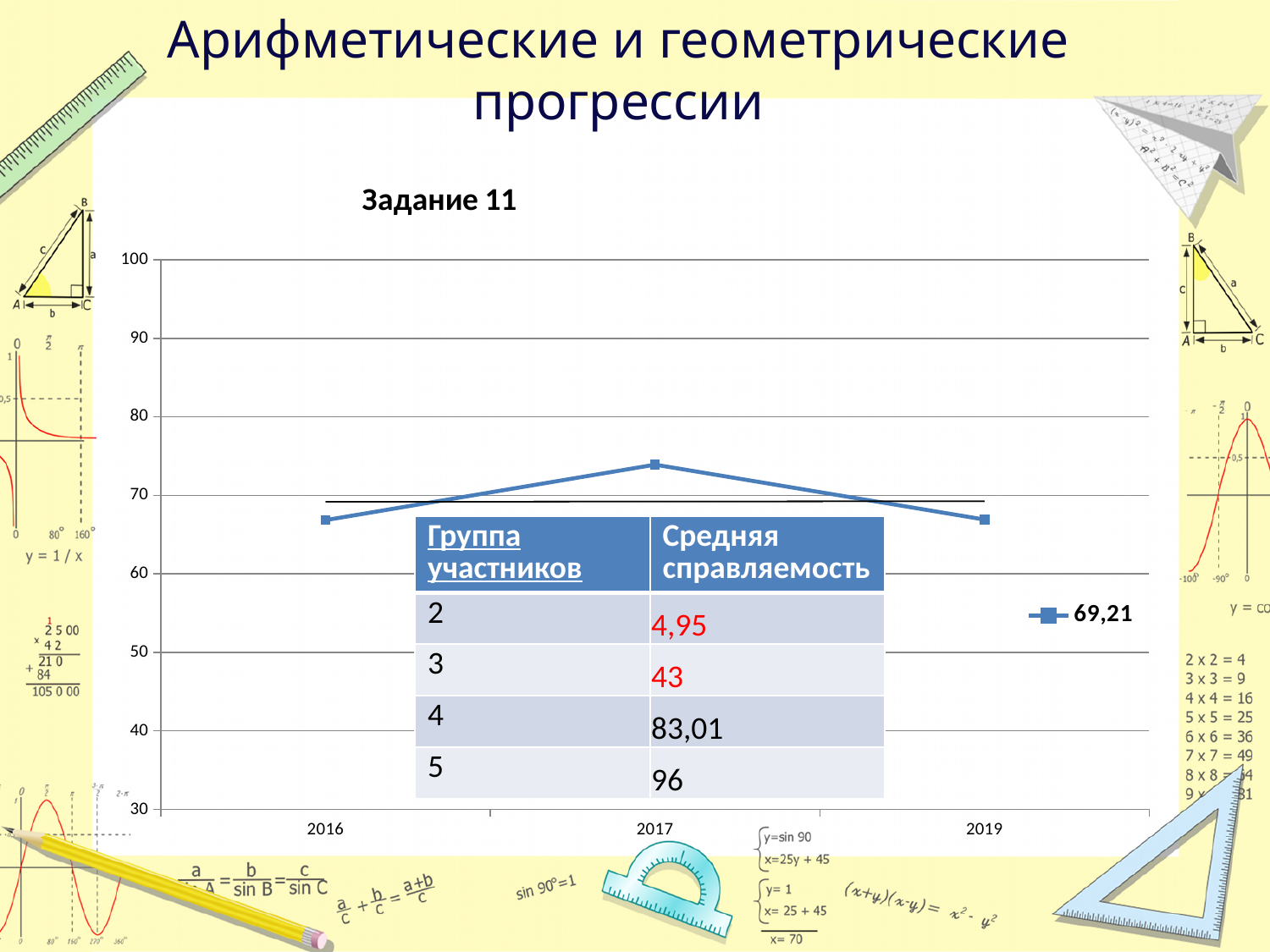
Is the value for 2019 greater or less than 70? less What is the legend entry for the plotted series? 69,21 Is the value for 2017 greater or less than 70? greater Which is larger, the value for 2016 or the value for 2017? 2017 Is the value for 2016 greater or less than 70? less What kind of chart is shown on the slide? line chart What is the title of the chart? Задание 11 How many series does the chart legend list? 1 How many data points are plotted on the line? 3 Which year has the highest value on the line? 2017 Does the line rise or fall from 2016 to 2017? rise Does the line rise or fall from 2017 to 2019? fall